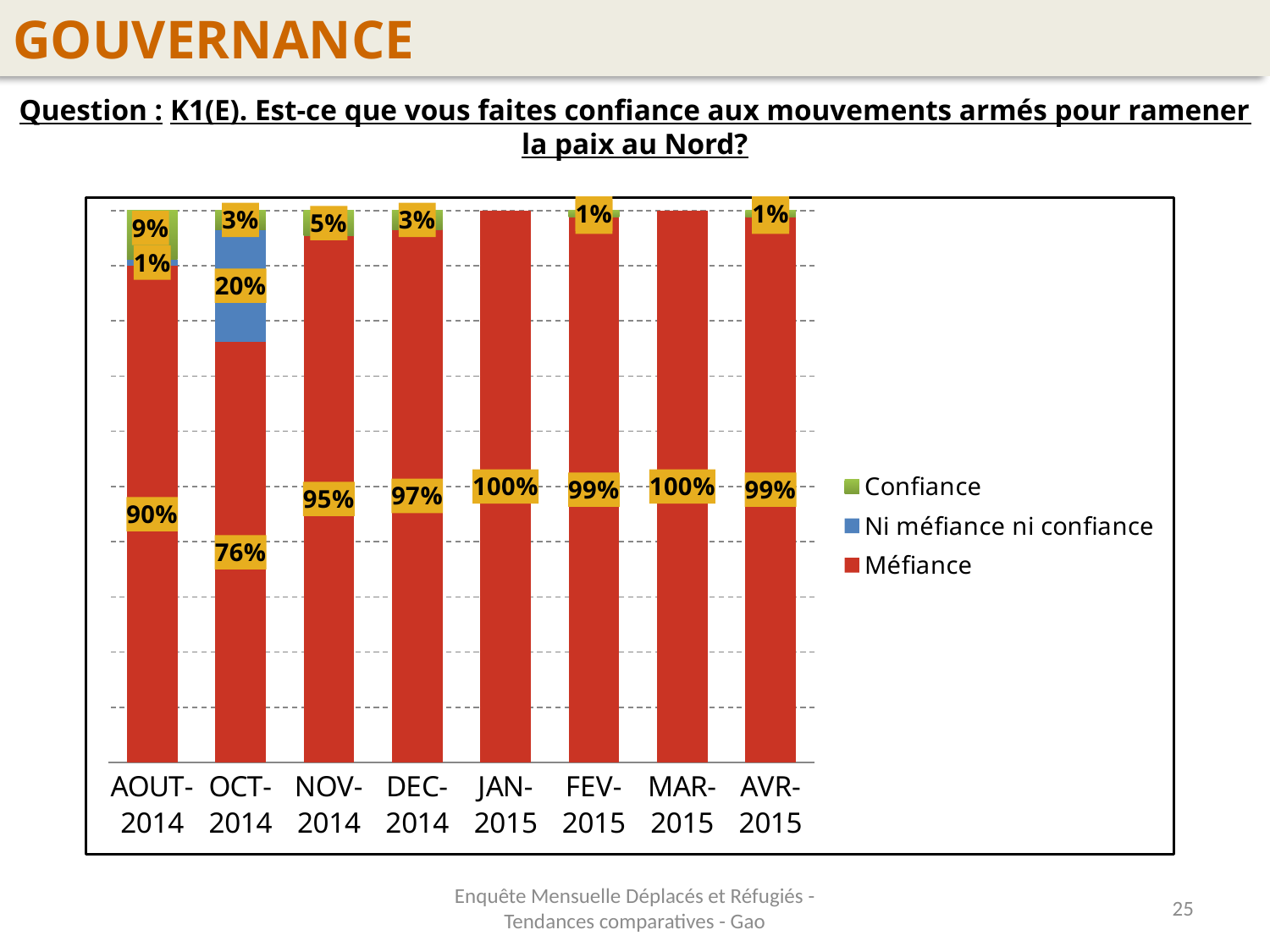
Which month has the highest Confiance value? AOUT-2014 What is the Ni méfiance ni confiance value for OCT-2014? 20% What is the Méfiance value for DEC-2014? 97% Which month has the lowest Méfiance value? OCT-2014 What is the difference between the Méfiance values for NOV-2014 and AOUT-2014? 5% How many series does the legend list? 3 What is the Confiance value for AOUT-2014? 9% What kind of chart is shown on the slide? Stacked bar chart Which legend entry is shown in red? Méfiance How many months are shown on the x axis? 8 Which is larger, the Méfiance value for FEV-2015 or for OCT-2014? FEV-2015 What is the Méfiance value for OCT-2014? 76%